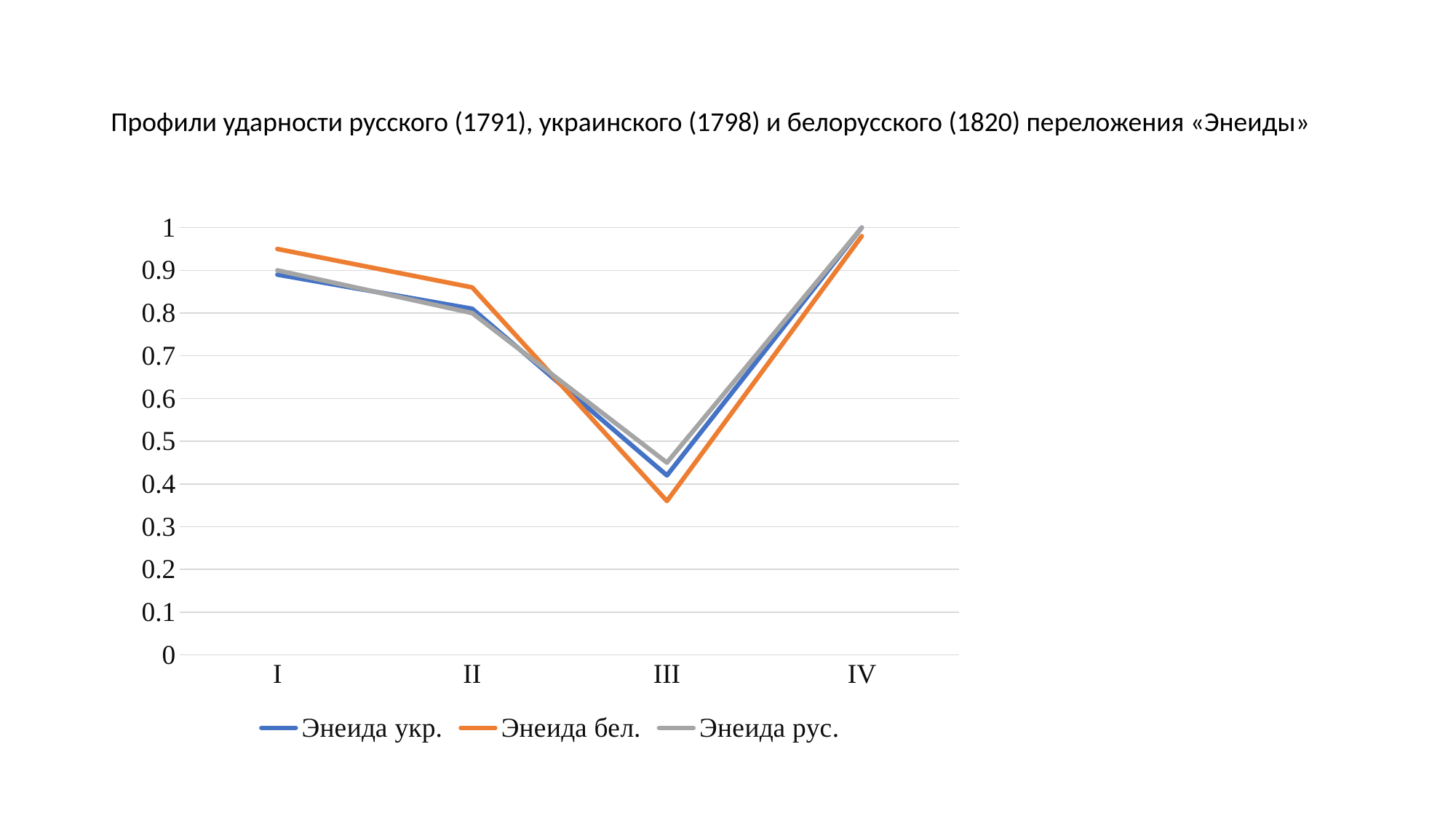
Is the value for Энеида бел. at category I greater or less than 0.9? greater Is the value for Энеида рус. at category III greater or less than 0.5? less Which series has the highest value at category I? Энеида бел. At which category does the Энеида укр. series reach its highest value? IV Which series has the lowest value at category III? Энеида бел. How many series does the legend list? 3 How many categories are shown on the x axis? 4 Is the value for Энеида бел. at category III greater or less than 0.4? less What kind of chart is shown on the slide? line chart What is the title of the chart? Профили ударности русского (1791), украинского (1798) и белорусского (1820) переложения «Энеиды» At which category does the Энеида бел. series reach its lowest value? III Do the values of the Энеида укр. series rise or fall from category II to category III? fall